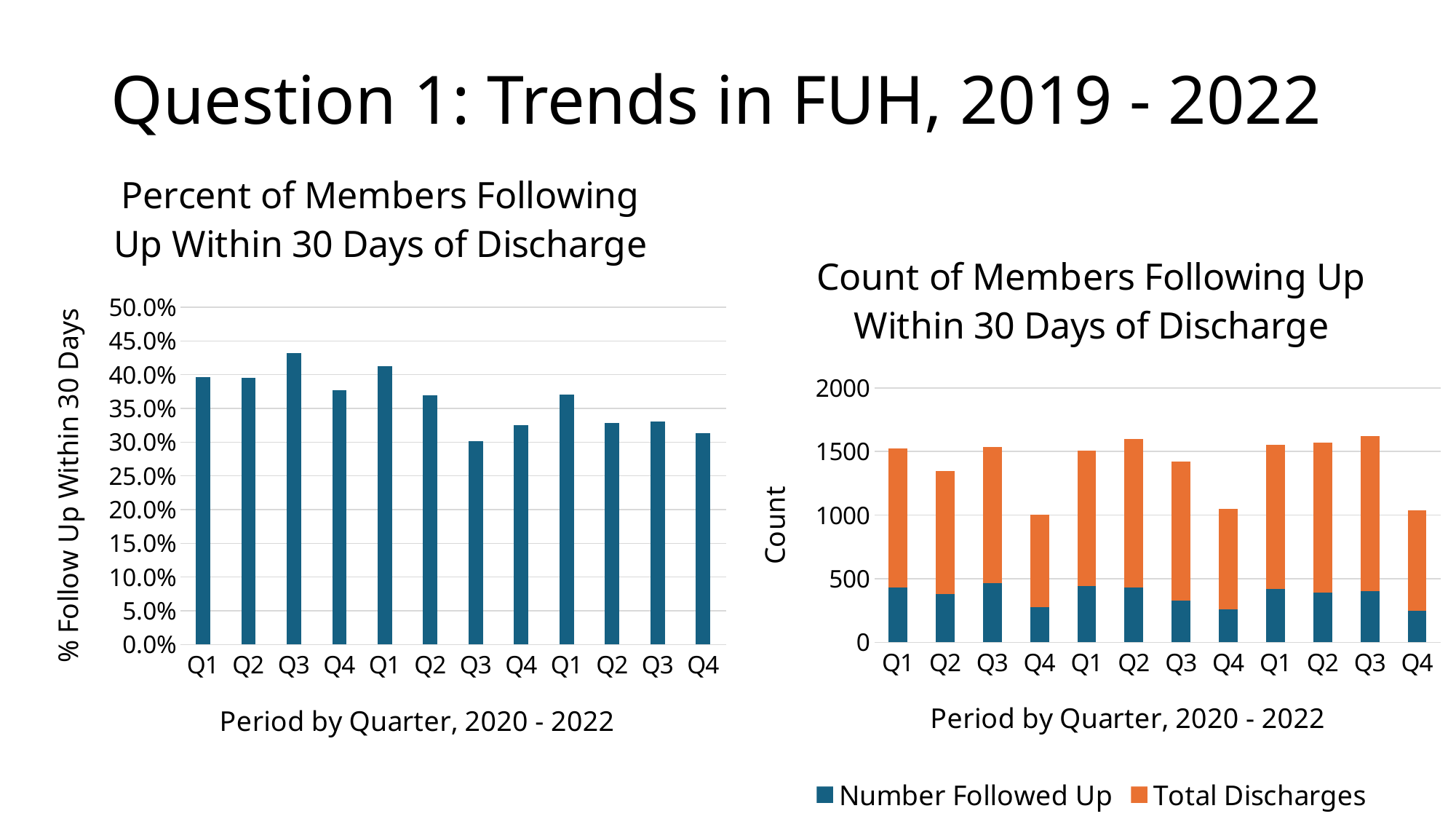
In the left chart, 'Percent of Members Following Up Within 30 Days of Discharge', which bar is the highest? The third bar from the left (the first Q3) In the right chart, 'Count of Members Following Up Within 30 Days of Discharge', is the total height of the fourth bar from the left (the first Q4) greater or less than 1500? less What are the two legend entries in the right chart, 'Count of Members Following Up Within 30 Days of Discharge'? Number Followed Up and Total Discharges In the left chart, 'Percent of Members Following Up Within 30 Days of Discharge', which is larger: the first Q3 bar or the first Q4 bar? The first Q3 bar What is the y-axis label of the left chart, 'Percent of Members Following Up Within 30 Days of Discharge'? % Follow Up Within 30 Days In the left chart, 'Percent of Members Following Up Within 30 Days of Discharge', is the value for the last Q4 bar (rightmost) greater or less than 35.0%? less How many bars are plotted in the left chart, 'Percent of Members Following Up Within 30 Days of Discharge'? 12 What kind of chart is the left chart, 'Percent of Members Following Up Within 30 Days of Discharge'? Bar chart In the right chart, 'Count of Members Following Up Within 30 Days of Discharge', is the total height of the sixth bar from the left (the second Q2) greater or less than 1500? greater In the left chart, 'Percent of Members Following Up Within 30 Days of Discharge', which bar is the lowest? The seventh bar from the left (the second Q3) How many series does the legend of the right chart, 'Count of Members Following Up Within 30 Days of Discharge', list? 2